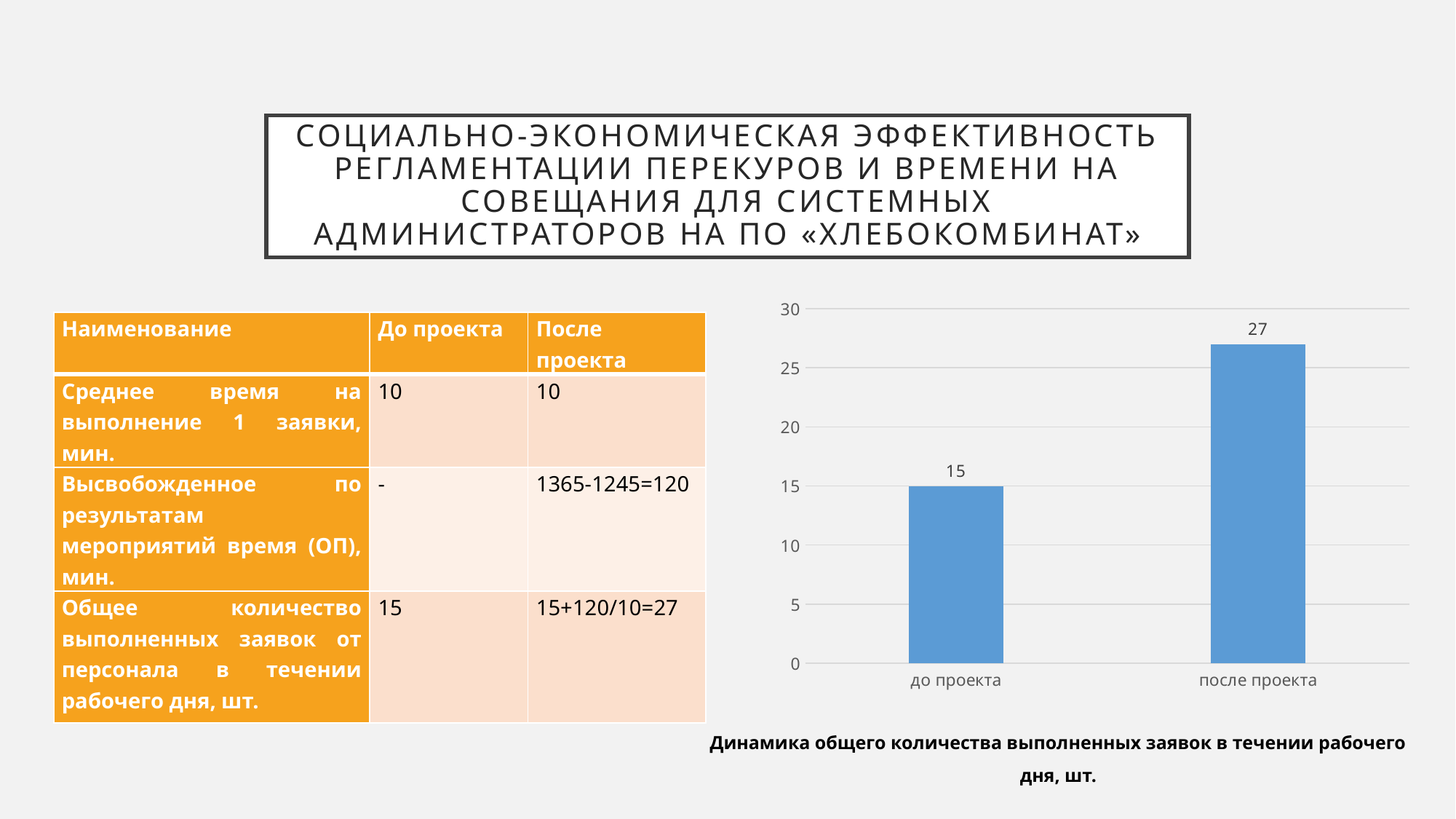
What is the value for "до проекта" in the chart? 15 Which category has the highest value in the chart? после проекта What is the caption below the chart? Динамика общего количества выполненных заявок в течении рабочего дня, шт. Do the values rise or fall from "до проекта" to "после проекта"? rise Which category has the lowest value in the chart? до проекта What is the value for "после проекта" in the chart? 27 What kind of chart is shown on the slide? bar chart Is the value for "после проекта" greater or less than 25? greater Which is larger: the value for "до проекта" or the value for "после проекта"? после проекта What is the difference between the values for "после проекта" and "до проекта"? 12 How many categories are shown in the chart? 2 Is the value for "до проекта" greater or less than 20? less